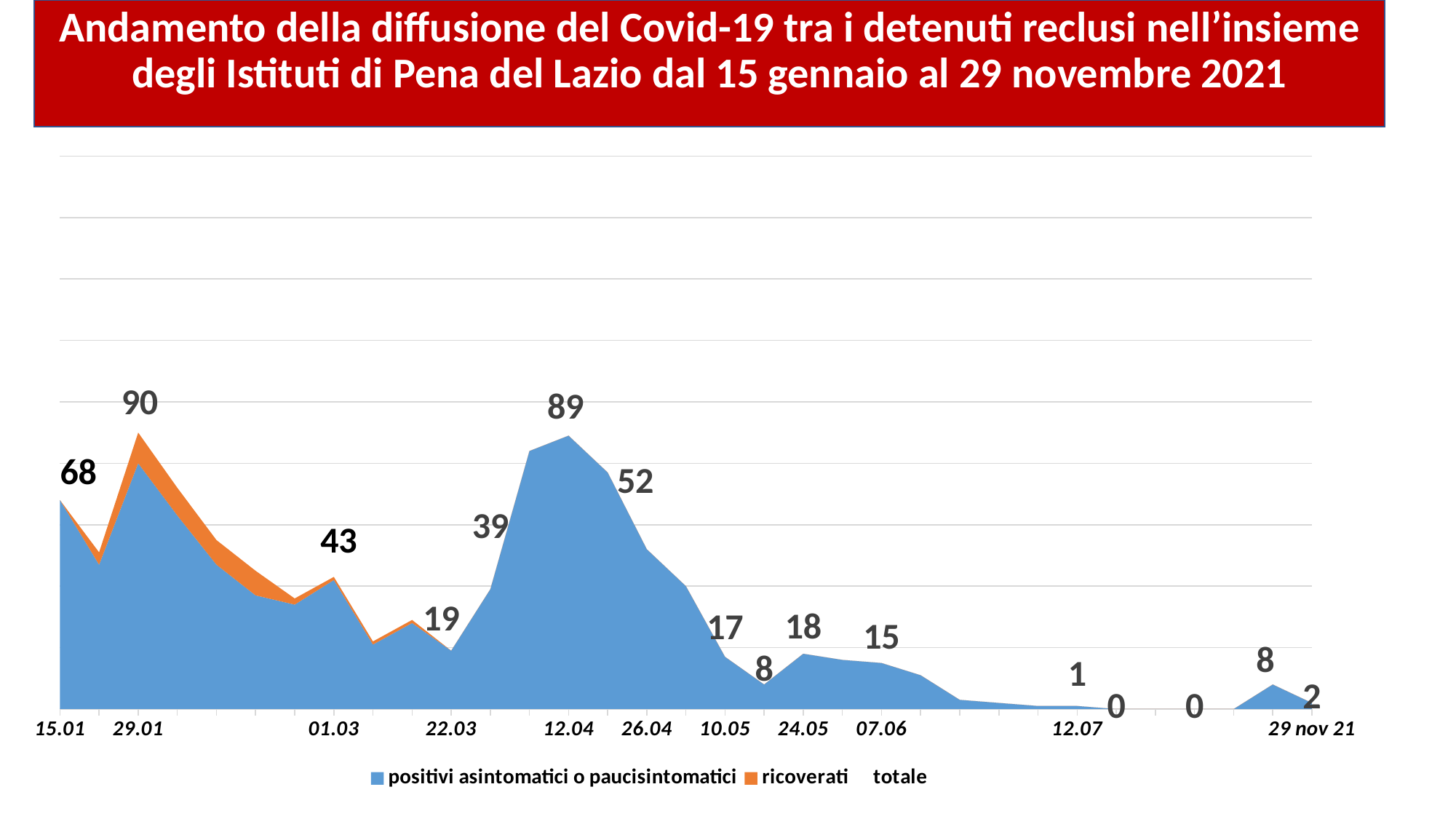
What is the total value shown for 12.04? 89 What is the total value shown for 29.01? 90 What is the total value shown for 01.03? 43 What is the difference between the total on 29.01 and the total on 12.04? 1 What is the total value shown for 07.06? 15 Which date has the larger total, 26.04 or 10.05? 26.04 What kind of chart is shown on the slide? Area chart What is the total value shown for 29 nov 21? 2 What is the difference between the total on 15.01 and the total on 01.03? 25 What is the total value shown for 15.01? 68 On which date does the total reach its highest value? 29.01 How many series does the legend list? 3